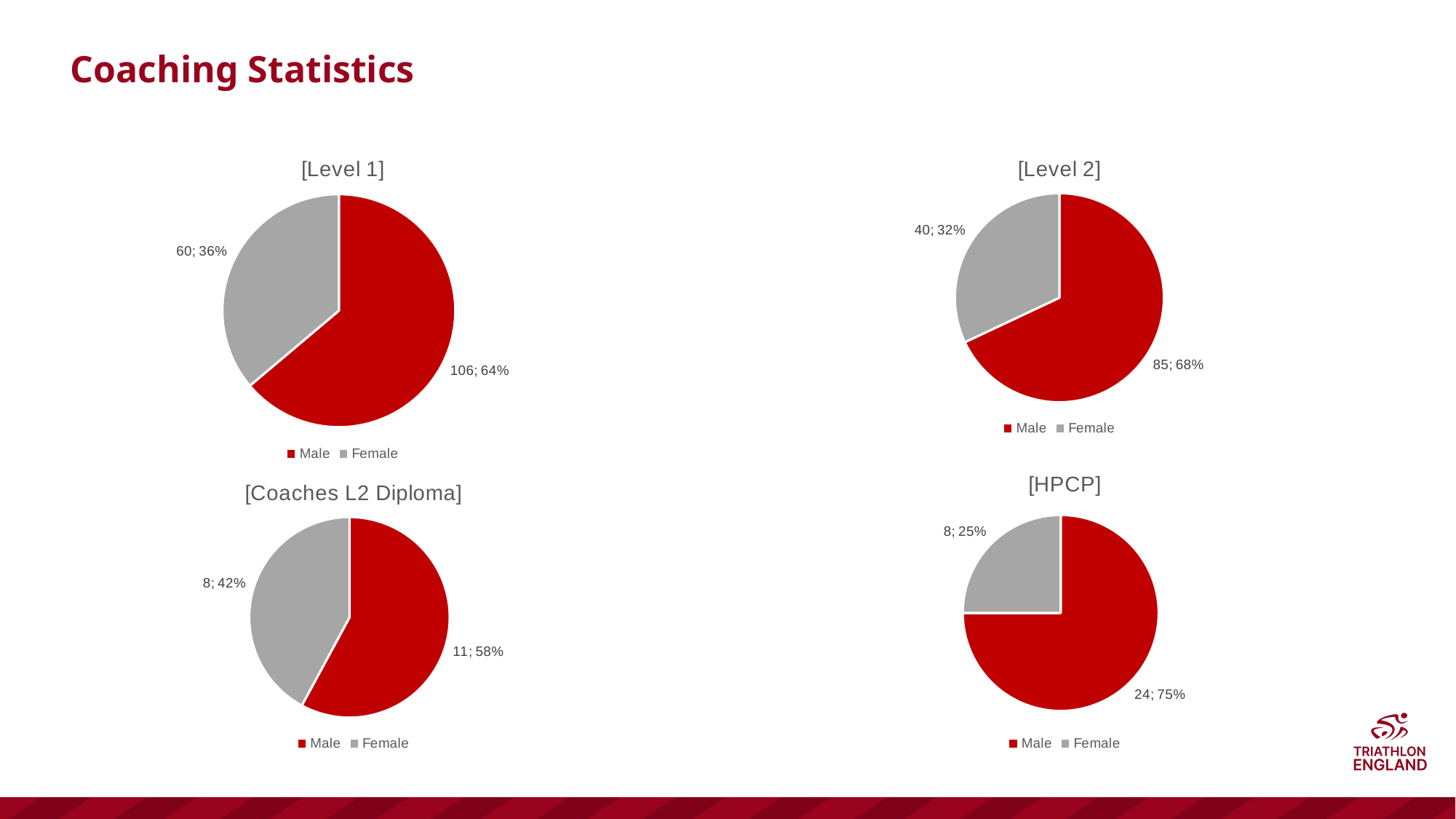
In the [HPCP] chart, which slice is larger, Male or Female? Male In the [Level 2] chart, what share of the pie is Male? 68% In the [HPCP] chart, what share of the pie is Female? 25% How many series does the legend of the [HPCP] chart list? 2 What kind of chart is the [Level 2] chart? Pie chart In the [Coaches L2 Diploma] chart, how many Male coaches are shown? 11 In the [Level 1] chart, what share of the pie is Female? 36% In the [Level 2] chart, what colour is the Female slice? Grey In the [Level 2] chart, how many Female coaches are shown? 40 In the [Level 1] chart, what is the difference between the Male and Female counts? 46 How many slices does the [Coaches L2 Diploma] chart have? 2 In the [Level 1] chart, how many Male coaches are shown? 106